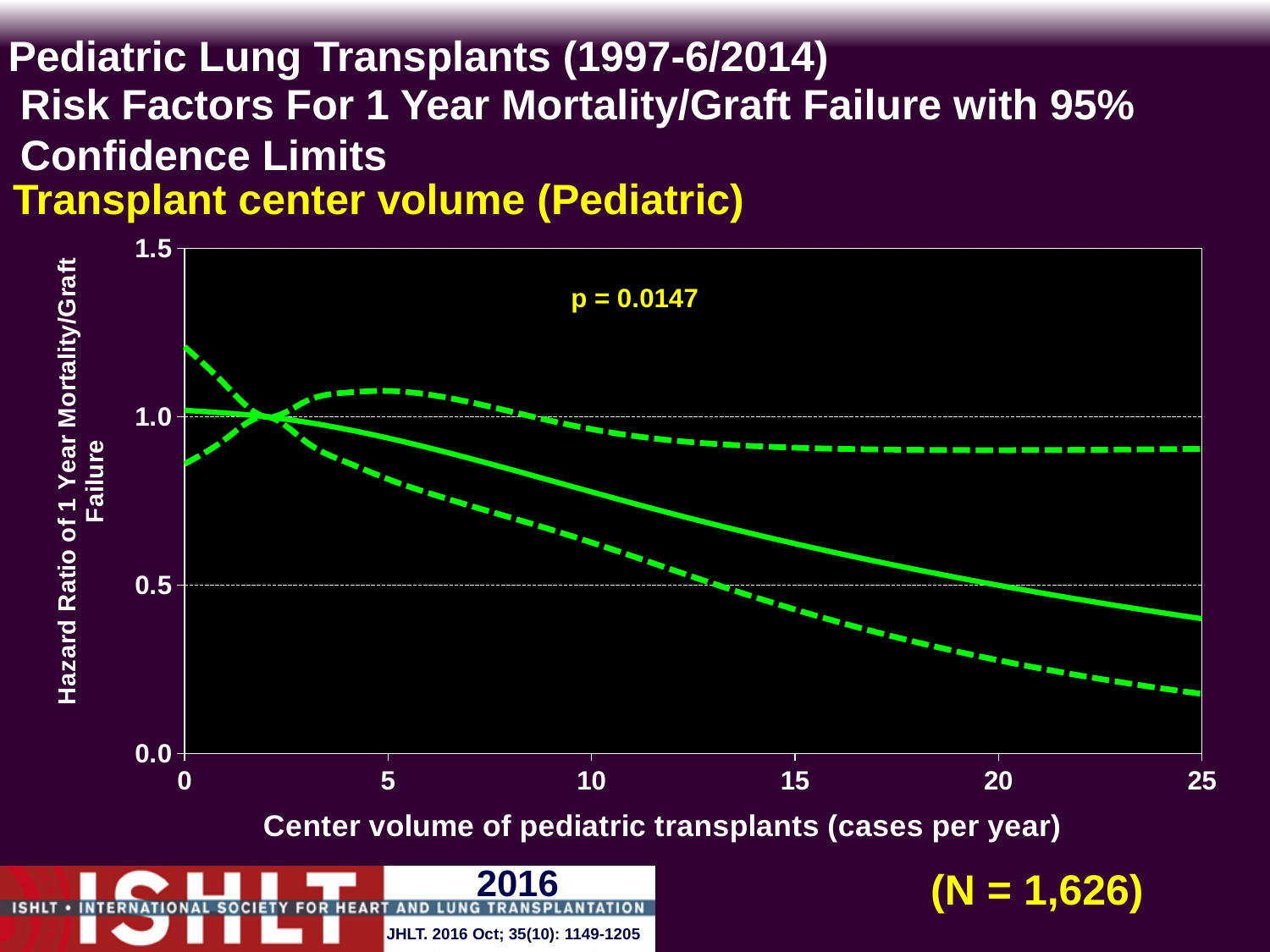
What sample size (N) is shown on the slide? N = 1,626 What kind of chart is shown on the slide? line chart What is the highest value shown on the y axis of the chart? 1.5 Is the value of the solid hazard ratio line at a center volume of 25 cases per year greater or less than 0.5? less How many lines are plotted on the chart? 3 Is the value of the solid hazard ratio line at a center volume of 10 cases per year greater or less than 0.5? greater Is the upper dashed confidence limit at a center volume of 25 cases per year greater or less than 1.0? less What p-value is printed on the chart? p = 0.0147 Does the solid hazard ratio line rise or fall as center volume increases from 5 to 25 cases per year? fall